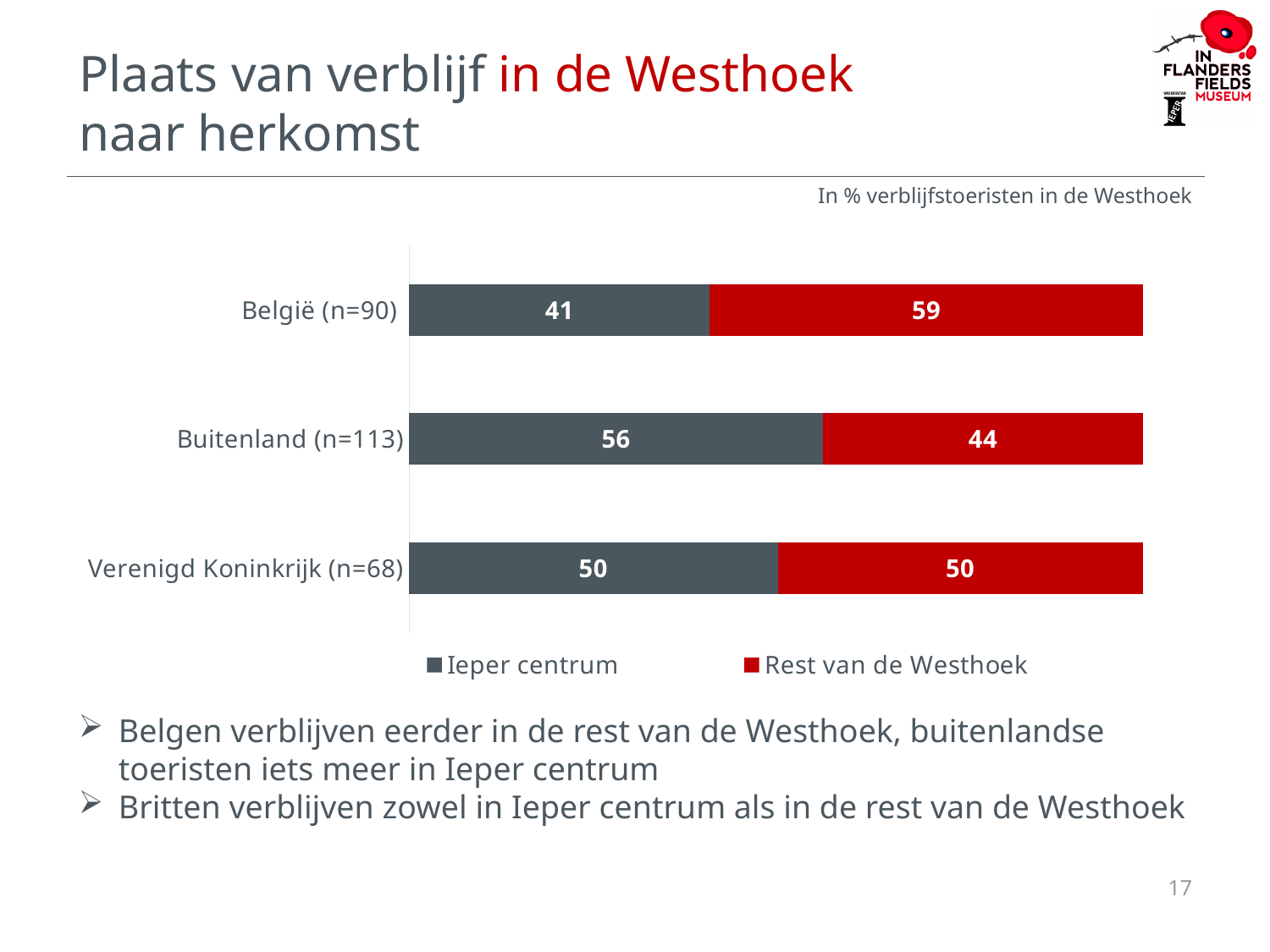
What is the value for Ieper centrum for Verenigd Koninkrijk (n=68)? 50 What is the total of the stacked bar for Verenigd Koninkrijk (n=68)? 100 How many series does the legend list? 2 What kind of chart is shown on the slide? Stacked bar chart How many categories are shown on the chart? 3 Which category has the highest value for Ieper centrum? Buitenland (n=113) What is the difference between the Rest van de Westhoek and Ieper centrum values for België (n=90)? 18 Which category has the lowest value for Rest van de Westhoek? Buitenland (n=113) What is the value for Rest van de Westhoek for België (n=90)? 59 What is the value for Rest van de Westhoek for Buitenland (n=113)? 44 For Buitenland (n=113), which is larger: Ieper centrum or Rest van de Westhoek? Ieper centrum What is the value for Ieper centrum for België (n=90)? 41